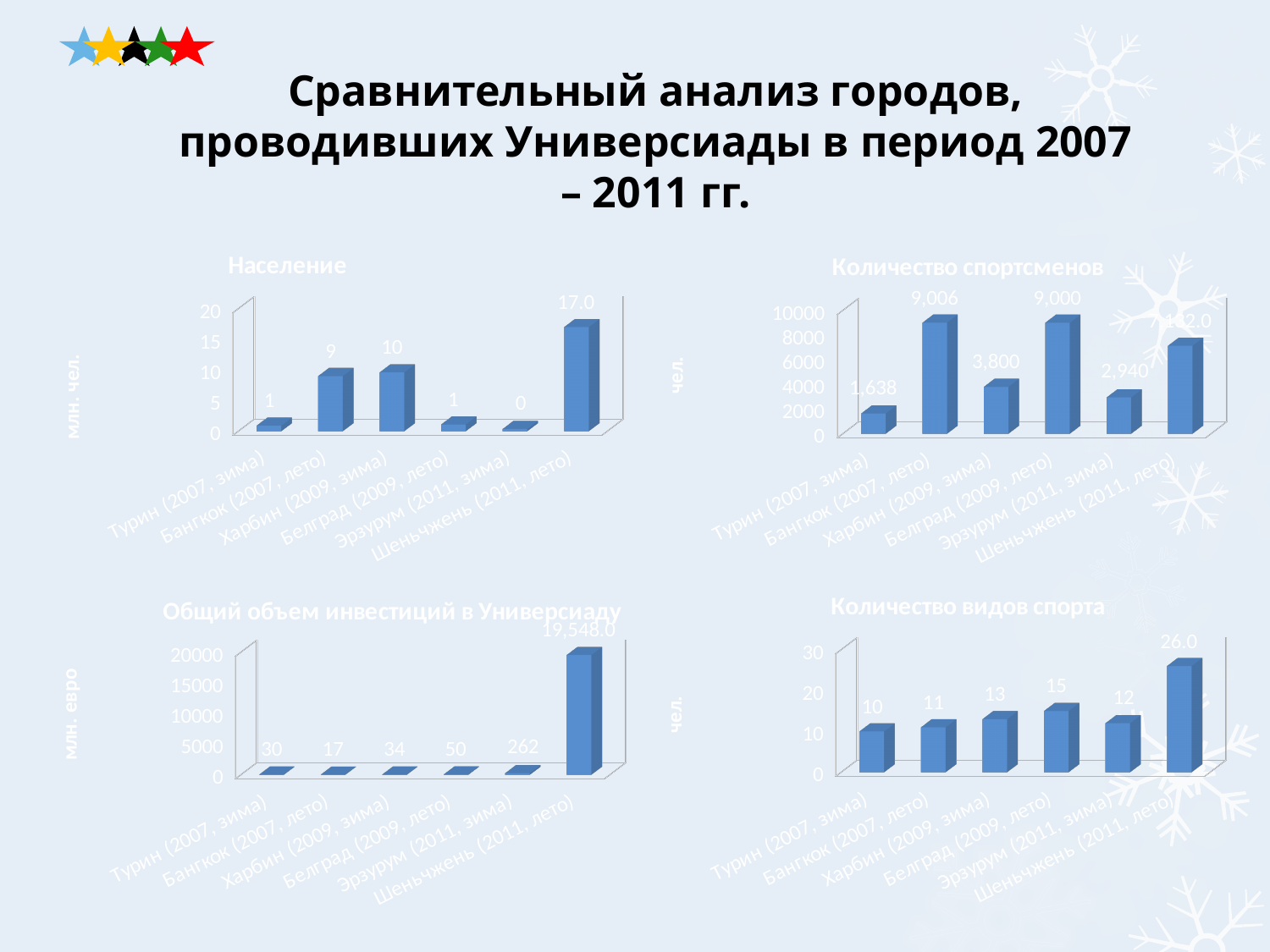
In the chart titled "Общий объем инвестиций в Универсиаду", which is larger: the value for Белград (2009, лето) or Харбин (2009, зима)? Белград (2009, лето) In the chart titled "Общий объем инвестиций в Универсиаду", which city has the highest value? Шеньчжень (2011, лето) In the chart titled "Население", what is the value for Шеньчжень (2011, лето)? 17.0 In the chart titled "Количество спортсменов", is the value for Эрзурум (2011, зима) greater or less than 4000? less In the chart titled "Количество спортсменов", what is the difference between Бангкок (2007, лето) and Харбин (2009, зима)? 5,206 What type of chart is the chart titled "Население"? bar chart How many categories are shown in the chart titled "Количество видов спорта"? 6 In the chart titled "Количество видов спорта", what is the difference between Шеньчжень (2011, лето) and Турин (2007, зима)? 16 In the chart titled "Количество спортсменов", what is the value for Турин (2007, зима)? 1,638 In the chart titled "Количество видов спорта", what is the value for Белград (2009, лето)? 15 In the chart titled "Население", which city has the lowest value? Эрзурум (2011, зима) In the chart titled "Общий объем инвестиций в Универсиаду", what is the value for Эрзурум (2011, зима)? 262